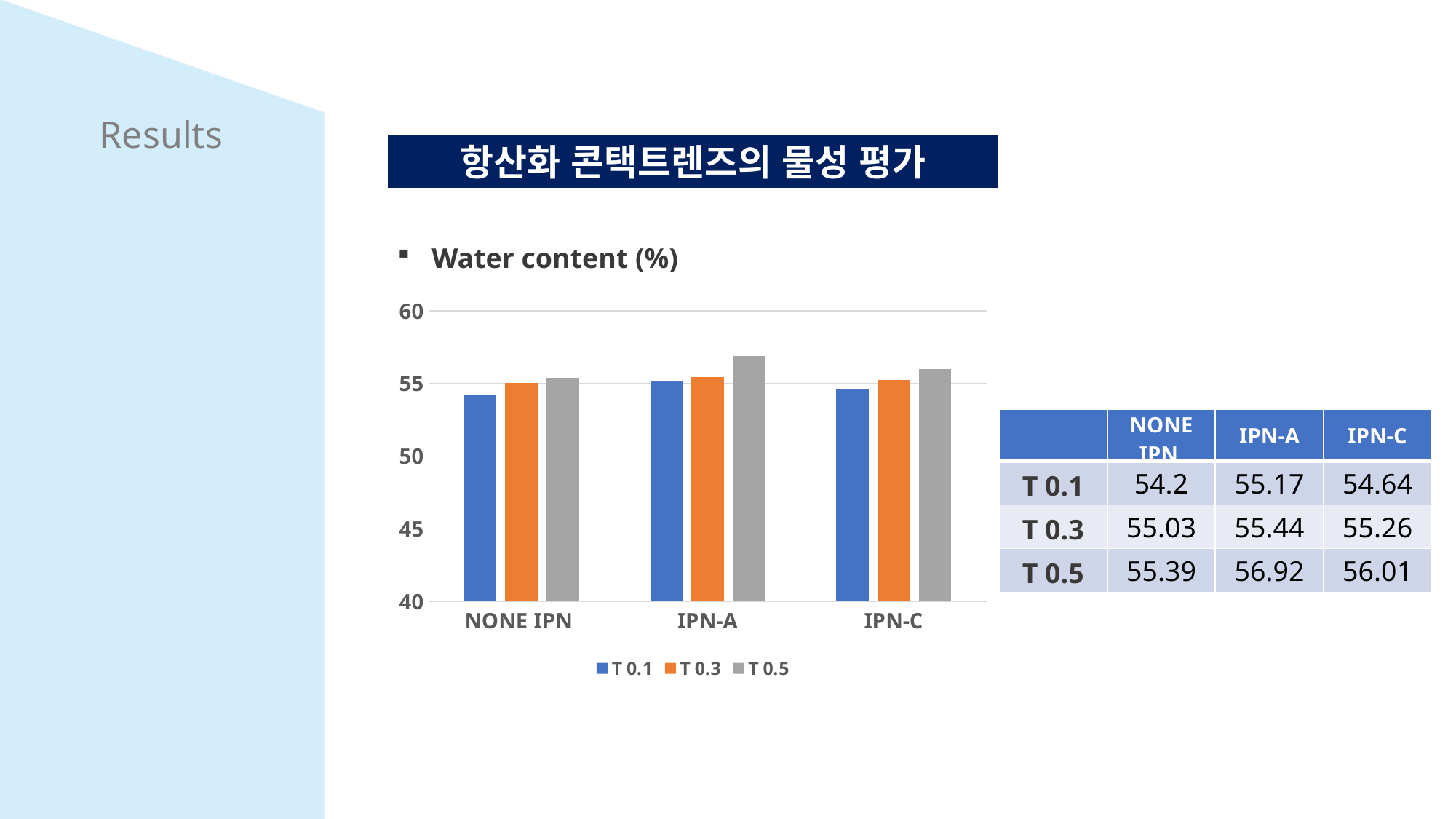
How many categories are shown on the x axis of the chart? 3 How many series does the chart legend list? 3 Within each category, do the values rise or fall from T 0.1 to T 0.5? rise What type of chart is shown on the slide? bar chart What is the water content value for NONE IPN in the T 0.1 series? 54.2 What is the water content value for IPN-A in the T 0.5 series? 56.92 Which category has the highest value in the T 0.5 series? IPN-A Is the T 0.1 value for NONE IPN greater or less than 55? less What is the difference between the T 0.5 values for IPN-A and NONE IPN? 1.53 What is the water content value for IPN-C in the T 0.3 series? 55.26 Which category has the lowest value in the T 0.1 series? NONE IPN Which is larger: the T 0.1 value for IPN-A or the T 0.1 value for IPN-C? IPN-A